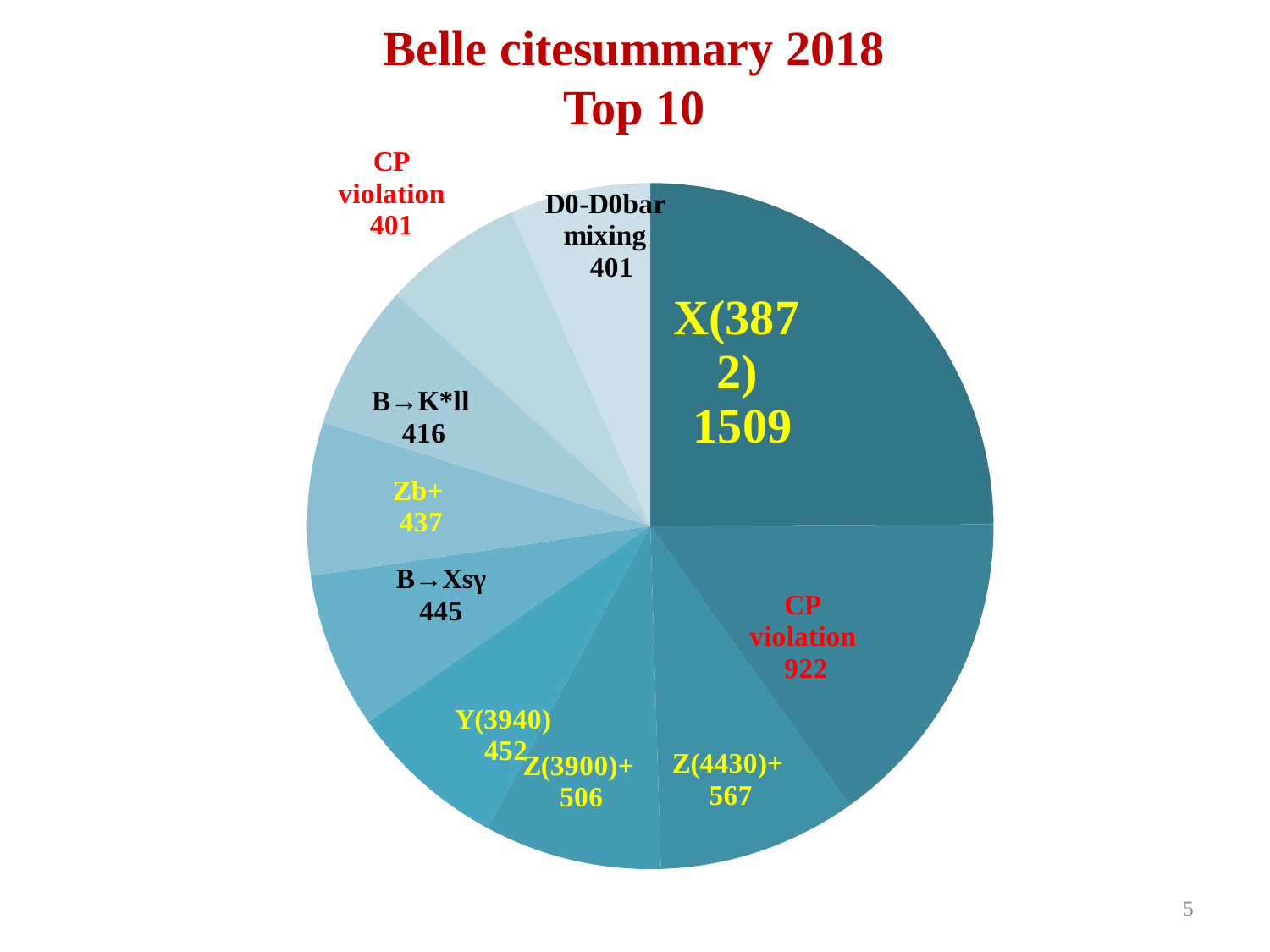
What is the value shown for B→K*ll? 416 What is the value shown for D0-D0bar mixing? 401 What is the title of the chart? Belle citesummary 2018 Top 10 What kind of chart is shown on the slide? Pie chart What is the difference between the X(3872) value and the larger CP violation value (922)? 587 Which is larger, the value for Y(3940) or the value for B→Xsγ? Y(3940) In what colour are the CP violation labels written? Red Which topic has the largest slice of the pie? X(3872) What is the value shown for X(3872)? 1509 What is the value shown for Z(4430)+? 567 What is the difference between the Z(4430)+ and Z(3900)+ values? 61 How many slices does the pie chart have? 10